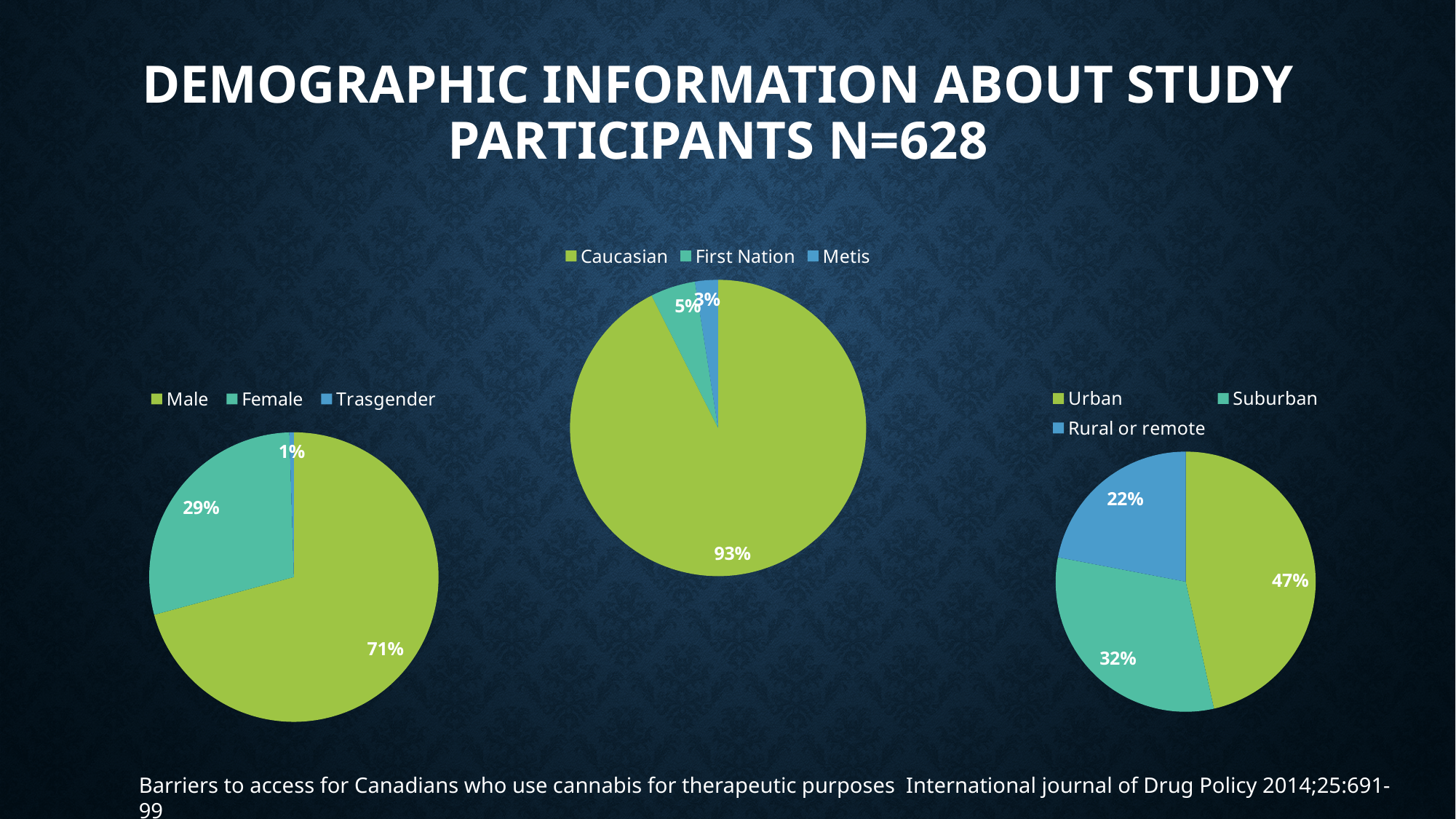
In the right pie chart, what share of participants are Urban? 47% In the left pie chart, what is the difference between the Male and Female shares? 42% In the left pie chart, what share of participants are Female? 29% In the left pie chart, which category has the largest share? Male In the left pie chart, what share of participants are Male? 71% In the middle pie chart, which category has the smallest share? Metis In the right pie chart, what share of participants are Rural or remote? 22% In the middle pie chart, what share of participants are First Nation? 5% In the middle pie chart, what share of participants are Caucasian? 93% How many pie charts are shown on the slide? 3 In the right pie chart, which is larger, Suburban or Rural or remote? Suburban In the left pie chart, what share of participants are Trasgender? 1%